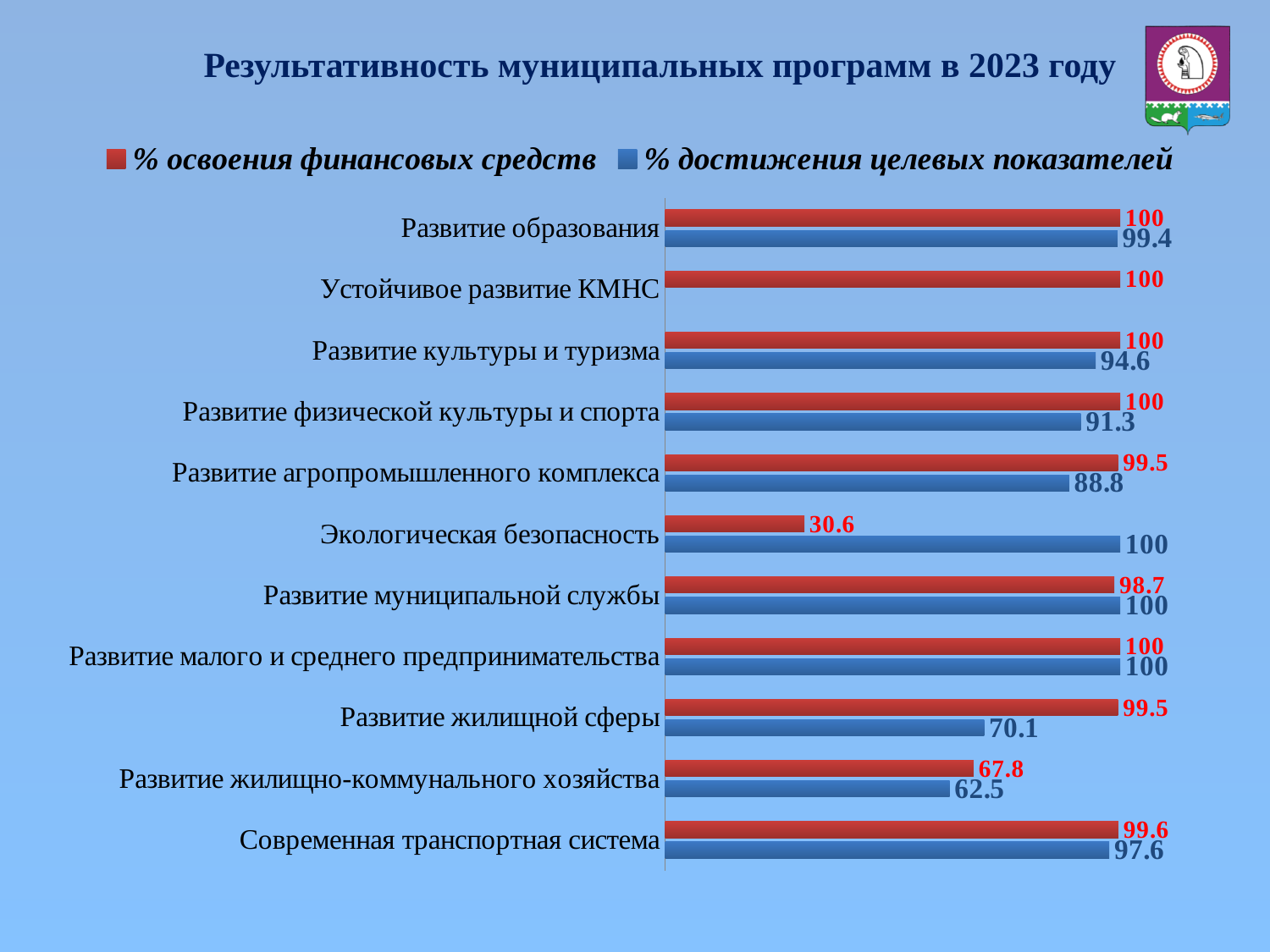
What is the value of «% достижения целевых показателей» for «Развитие жилищной сферы»? 70.1 What is the value of «% достижения целевых показателей» for «Развитие агропромышленного комплекса»? 88.8 How many programs (categories) are shown on the chart? 11 Which program has the lowest value of «% достижения целевых показателей»? Развитие жилищно-коммунального хозяйства How many series does the legend list? 2 What is the difference between «% освоения финансовых средств» and «% достижения целевых показателей» for «Развитие жилищной сферы»? 29.4 What type of chart is shown on the slide? Bar chart What is the difference between «% освоения финансовых средств» and «% достижения целевых показателей» for «Развитие жилищно-коммунального хозяйства»? 5.3 Which program has the lowest value of «% освоения финансовых средств»? Экологическая безопасность For «Развитие муниципальной службы», which is larger: «% освоения финансовых средств» or «% достижения целевых показателей»? % достижения целевых показателей What is the value of «% освоения финансовых средств» for «Современная транспортная система»? 99.6 What is the value of «% освоения финансовых средств» for «Экологическая безопасность»? 30.6